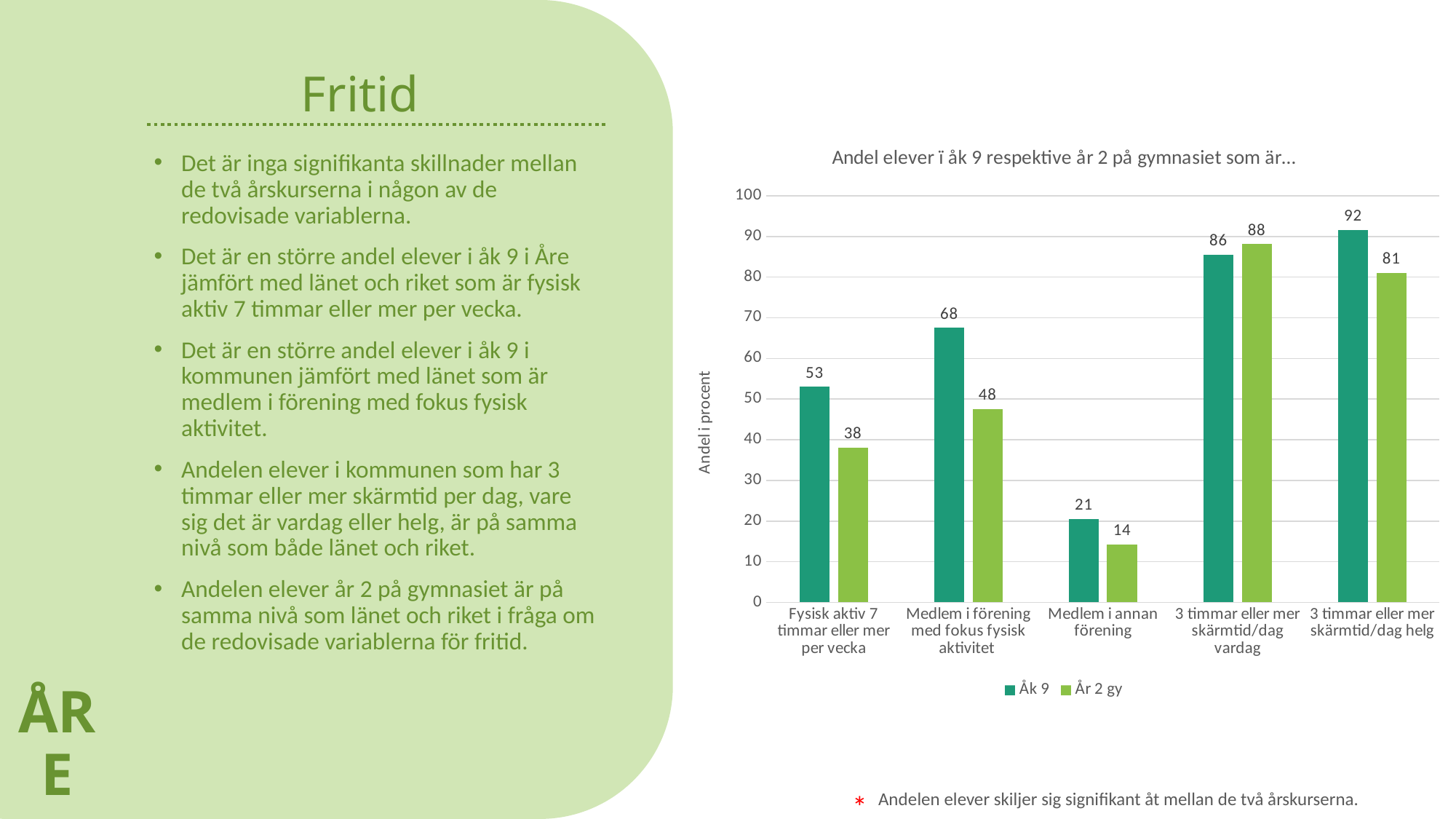
In the category '3 timmar eller mer skärmtid/dag vardag', which series has the larger value, Åk 9 or År 2 gy? År 2 gy What are the two series listed in the chart legend? Åk 9 and År 2 gy What is the label of the y axis of the chart? Andel i procent What is the difference between Åk 9 and År 2 gy in the category 'Medlem i förening med fokus fysisk aktivitet'? 20 How many series does the legend list? 2 What is the value for År 2 gy in the category '3 timmar eller mer skärmtid/dag helg'? 81 What is the value for År 2 gy in the category 'Medlem i annan förening'? 14 What is the value for Åk 9 in the category 'Fysisk aktiv 7 timmar eller mer per vecka'? 53 How many categories are shown on the x axis of the chart? 5 Which category has the highest value for Åk 9? 3 timmar eller mer skärmtid/dag helg Which category has the lowest value for År 2 gy? Medlem i annan förening What kind of chart is shown on the slide? Bar chart